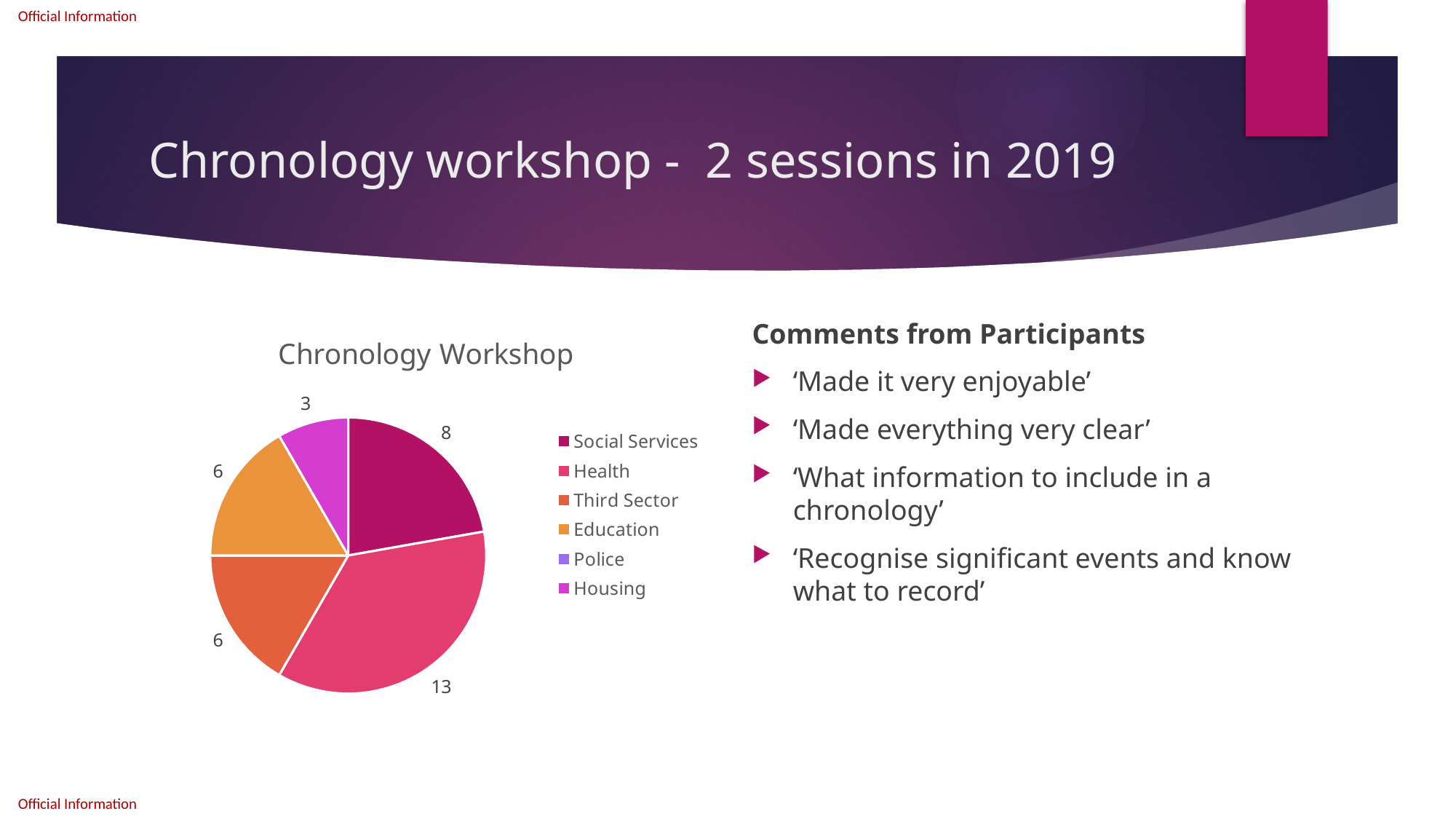
How many entries does the legend of the pie chart list? 6 What is the title of the pie chart? Chronology Workshop What is the value for Education in the pie chart? 6 Which labelled slice is the smallest in the pie chart? Housing What is the value for Health in the Chronology Workshop pie chart? 13 What is the difference between the values for Social Services and Housing? 5 What kind of chart is shown on the slide? pie chart What is the value for Housing in the pie chart? 3 What is the value for Social Services in the pie chart? 8 Which category has the largest slice in the pie chart? Health Which is larger, the value for Social Services or the value for Education? Social Services What is the difference between the values for Health and Social Services? 5